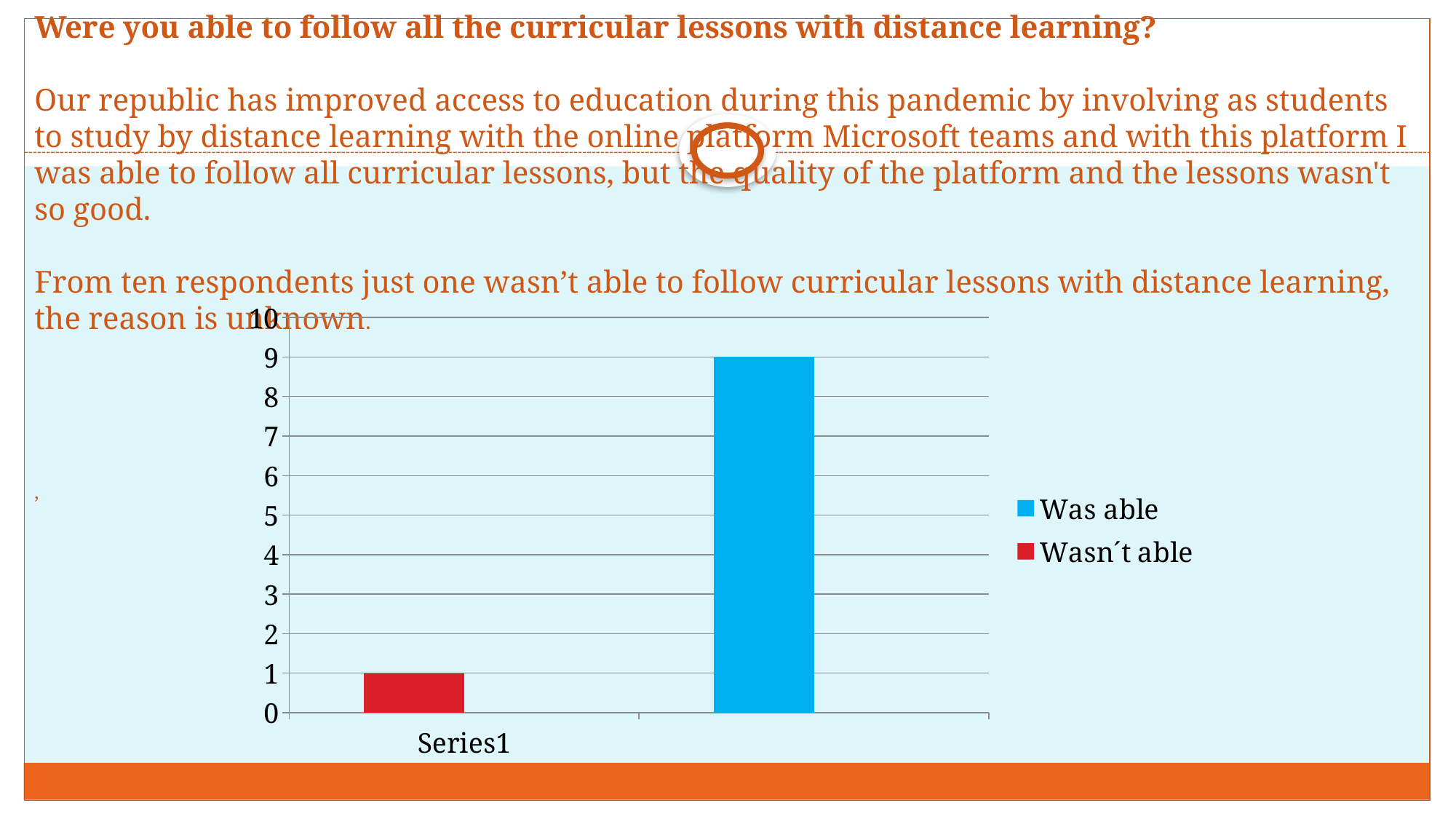
What value does the bar for "Was able" reach? 9 How many bars are plotted on the chart? 2 What is the difference between the "Was able" and "Wasn´t able" values? 8 What colour is the bar for "Wasn´t able"? red What kind of chart is shown on the slide? bar chart Which legend entry has the shortest bar? Wasn´t able Which legend entry has the tallest bar? Was able Is the value for "Was able" greater or less than 5? greater What value does the bar for "Wasn´t able" reach? 1 Which is larger, the value for "Was able" or for "Wasn´t able"? Was able What is the combined total of the "Was able" and "Wasn´t able" values? 10 How many entries does the legend list? 2